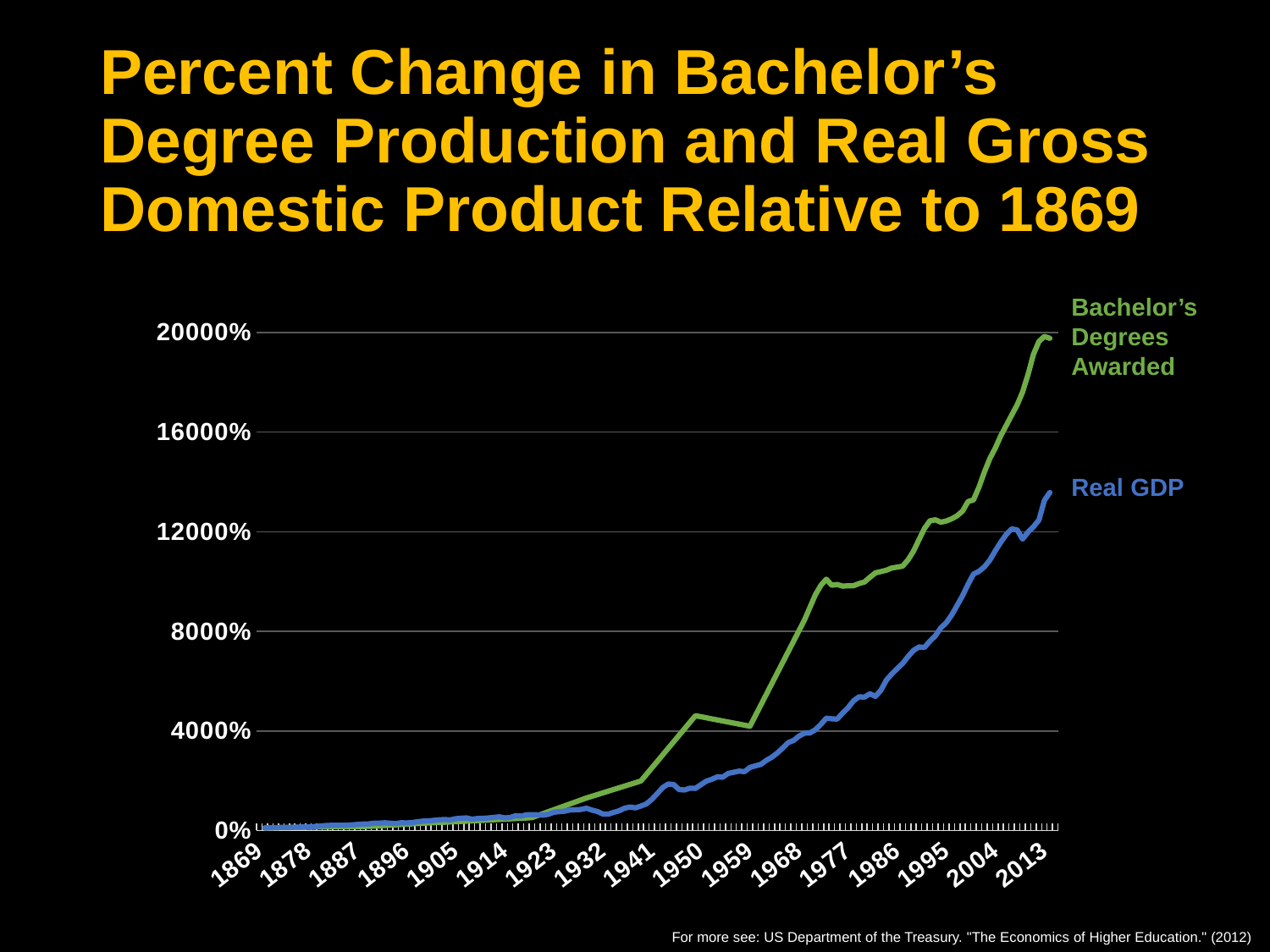
Is the value for Bachelor's Degrees Awarded in 2013 greater or less than 16000%? greater Is the value for Bachelor's Degrees Awarded in 1977 greater or less than 8000%? greater What kind of chart is shown on the slide? line chart Is the value for Bachelor's Degrees Awarded in 1941 greater or less than 4000%? less How many year labels are shown along the x axis? 17 Which series is drawn in green? Bachelor's Degrees Awarded What are the names of the two series plotted on the chart? Bachelor's Degrees Awarded and Real GDP How many series are plotted on the chart? 2 Overall, do the values for Real GDP rise or fall from 1869 to 2013? rise Which series reaches the higher value at the right end of the chart (2013)? Bachelor's Degrees Awarded